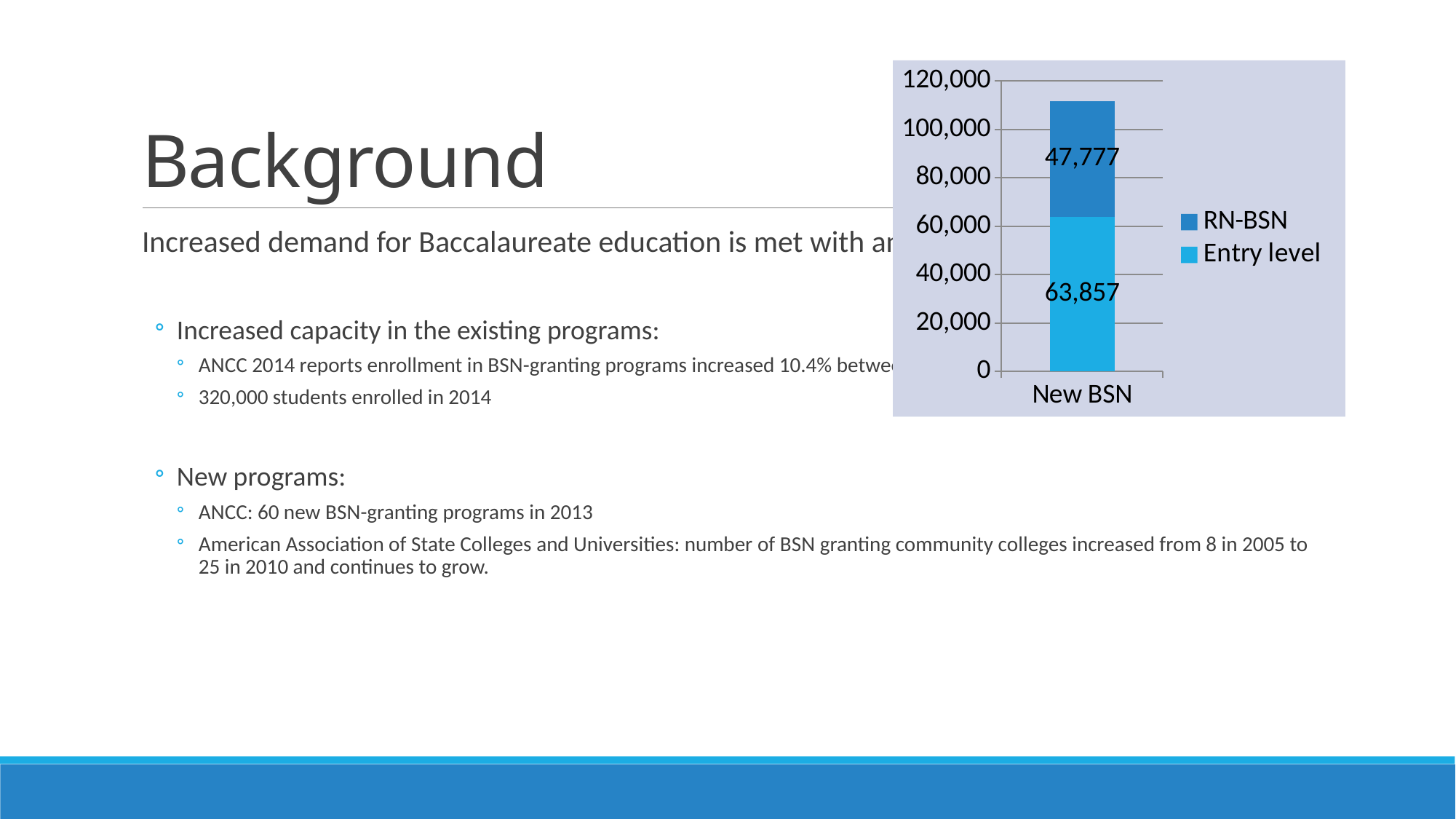
What is the difference between the Entry level value and the RN-BSN value? 16,080 What kind of chart is shown on the slide? Stacked bar chart What is the total of the stacked New BSN bar? 111,634 Is the Entry level value greater or less than 60,000? greater What is the value for RN-BSN in the New BSN bar? 47,777 Which legend entry is shown in the lighter blue colour? Entry level What is the label of the category on the x axis? New BSN How many series does the legend list? 2 Which series has the larger value in the New BSN bar, RN-BSN or Entry level? Entry level Is the total height of the New BSN bar greater or less than 100,000? greater How many categories are shown on the x axis? 1 What is the value for Entry level in the New BSN bar? 63,857